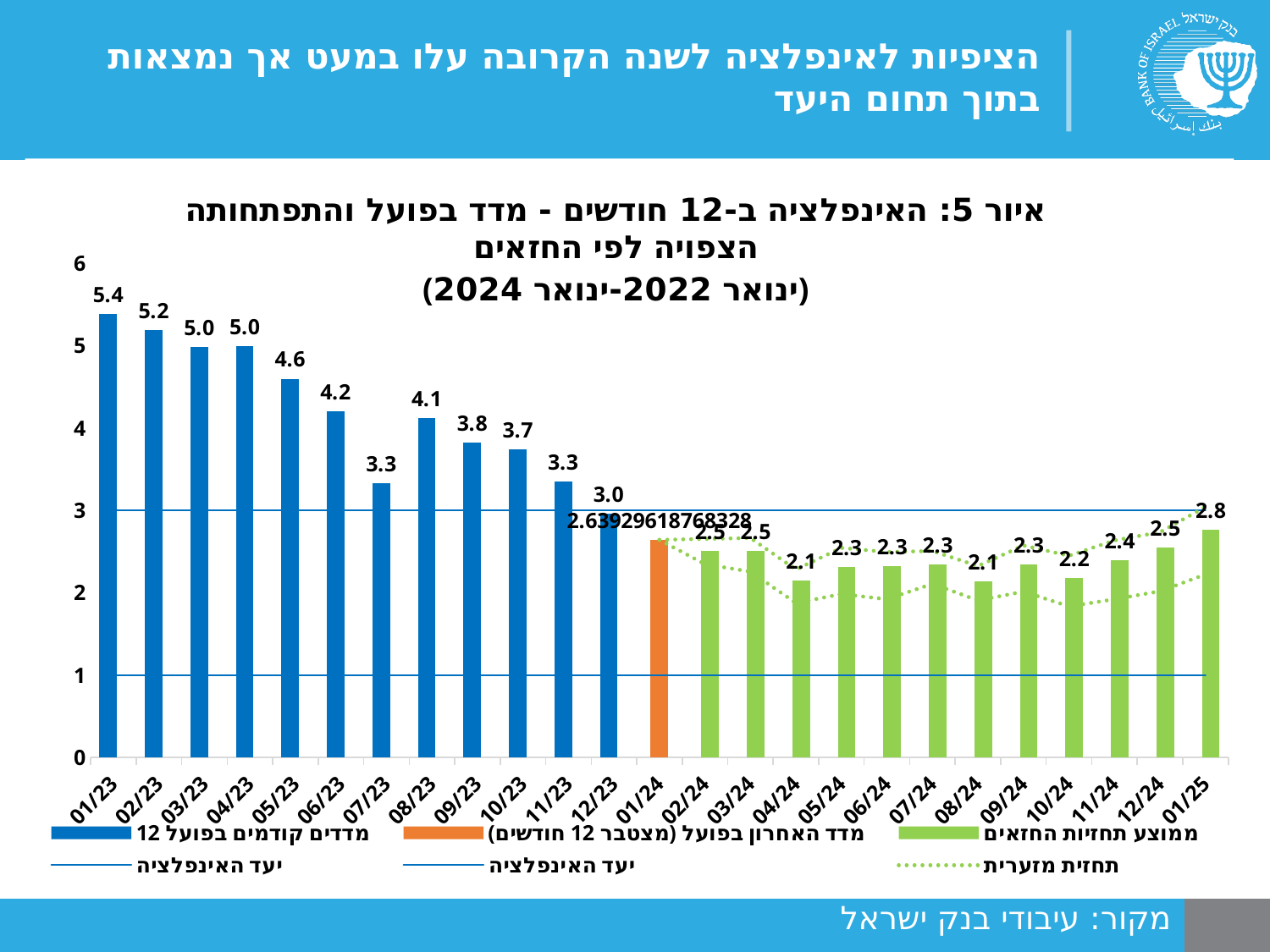
What is the value for 07/23? 3.3 What is the value for 01/23? 5.4 What is the value for 12/23? 3.0 What is the value for 01/25? 2.8 Do the values generally rise or fall from 01/23 to 12/23? fall Which is larger, the value for 08/23 or the value for 09/23? 08/23 How many bars are plotted in the chart? 25 How many entries does the legend list? 6 What is the difference between the values for 01/23 and 02/23? 0.2 Which month has the highest bar? 01/23 Is the value for 04/24 greater or less than 3? less What kind of chart is shown? combination bar and line chart